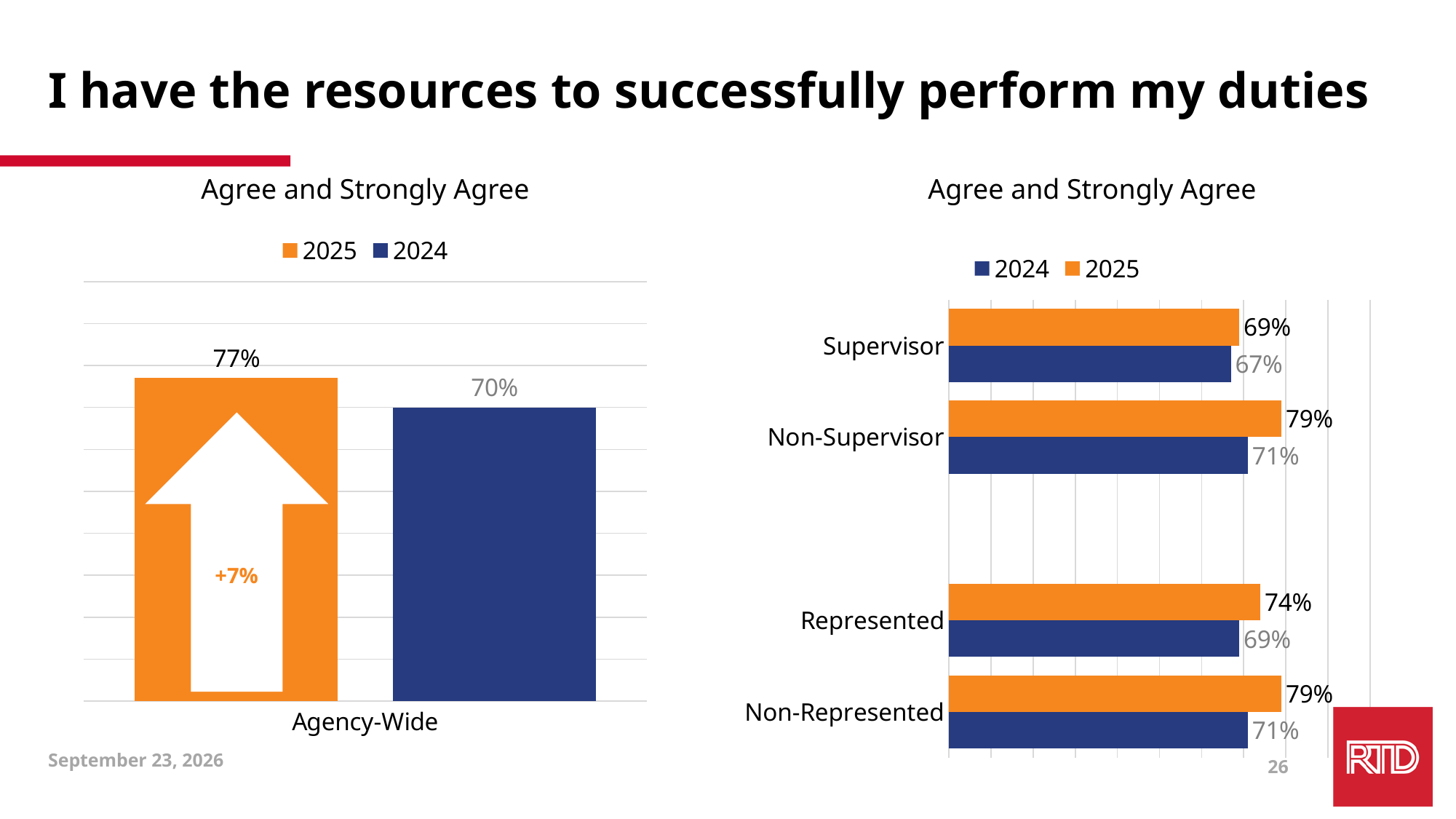
In the right chart, which category has the lowest 2024 value? Supervisor In the right chart, what is the 2025 value for Supervisor? 69% In the right chart, which is larger: the 2025 value for Supervisor or the 2025 value for Non-Supervisor? Non-Supervisor In the right chart, how many categories are shown? 4 In the left chart (Agency-Wide), what is the difference between the 2025 and 2024 values? 7% In the left chart (Agency-Wide), what is the value for 2025? 77% In the right chart, what is the 2024 value for Non-Supervisor? 71% In the left chart (Agency-Wide), how many series does the legend list? 2 In the right chart, what is the 2025 value for Represented? 74% In the right chart, what is the difference between the 2025 and 2024 values for Non-Represented? 8% What kind of chart is the left chart (Agency-Wide)? Bar chart In the left chart (Agency-Wide), what is the value for 2024? 70%